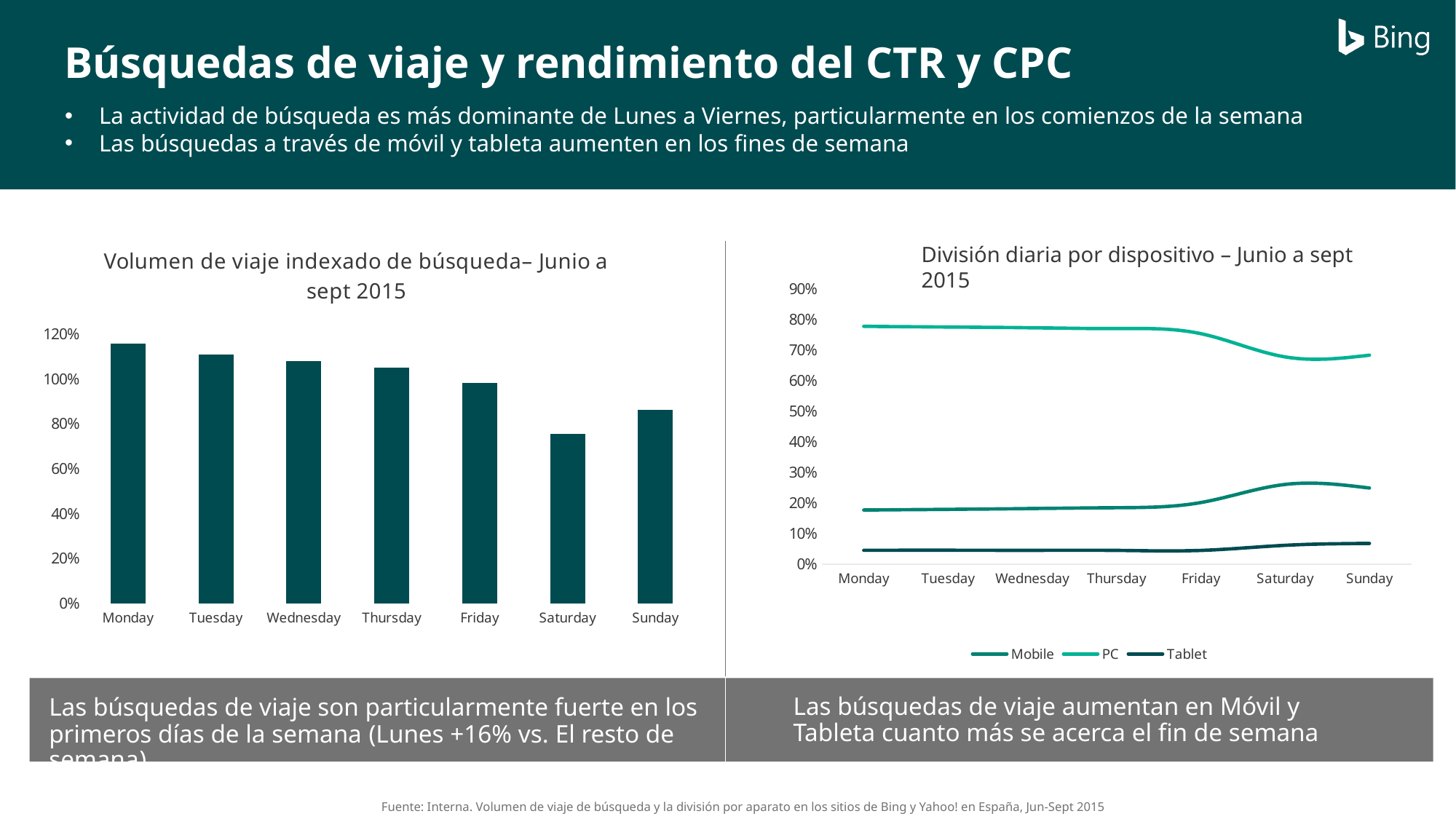
In the right line chart, which device series has the highest share across the week? PC In the left bar chart, do the values generally rise or fall from Monday to Saturday? fall What kind of chart is the 'División diaria por dispositivo' chart on the right? line chart What kind of chart is the 'Volumen de viaje indexado de búsqueda' chart on the left? bar chart In the right line chart, is the Mobile value for Saturday greater or less than 20%? greater In the left bar chart, is the value for Saturday greater or less than 80%? less In the left bar chart, is the value for Monday greater or less than 100%? greater In the left bar chart, which day has the lowest indexed travel search volume? Saturday How many series does the legend of the right line chart list? 3 In the left bar chart, how many days of the week are plotted? 7 In the left bar chart, which day has the highest indexed travel search volume? Monday In the left bar chart, which is larger, the value for Sunday or the value for Saturday? Sunday